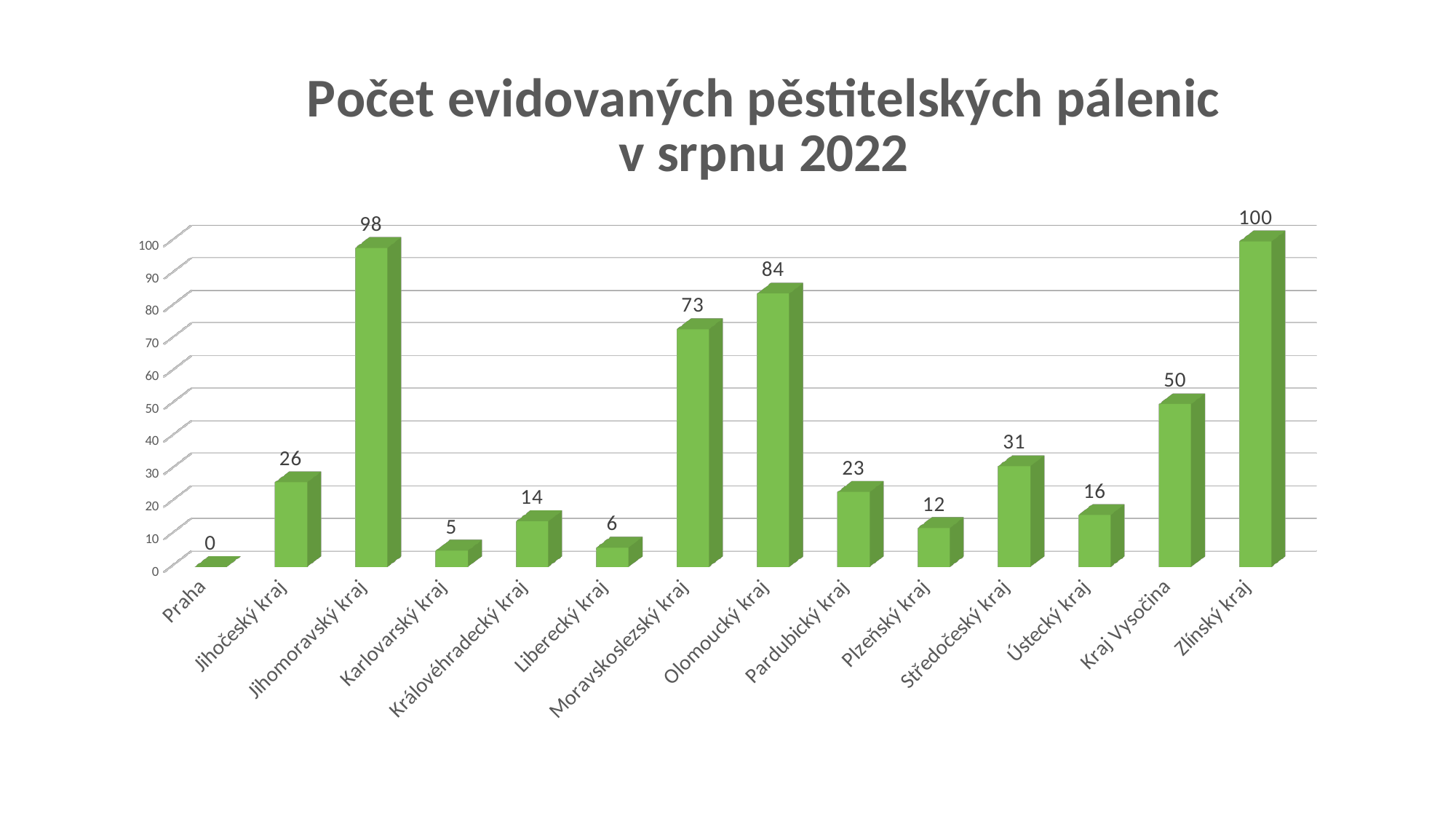
What is the title of the chart? Počet evidovaných pěstitelských pálenic v srpnu 2022 What is the value for Olomoucký kraj? 84 What is the value for Jihomoravský kraj? 98 What kind of chart is shown on the slide? bar chart What is the difference between the values for Zlínský kraj and Jihomoravský kraj? 2 What is the difference between the values for Olomoucký kraj and Moravskoslezský kraj? 11 Which region has the lowest value? Praha Is the value for Pardubický kraj greater or less than 20? greater What is the value for Kraj Vysočina? 50 How many regions are shown on the chart? 14 Which region has the highest value? Zlínský kraj Which is larger, the value for Středočeský kraj or the value for Jihočeský kraj? Středočeský kraj